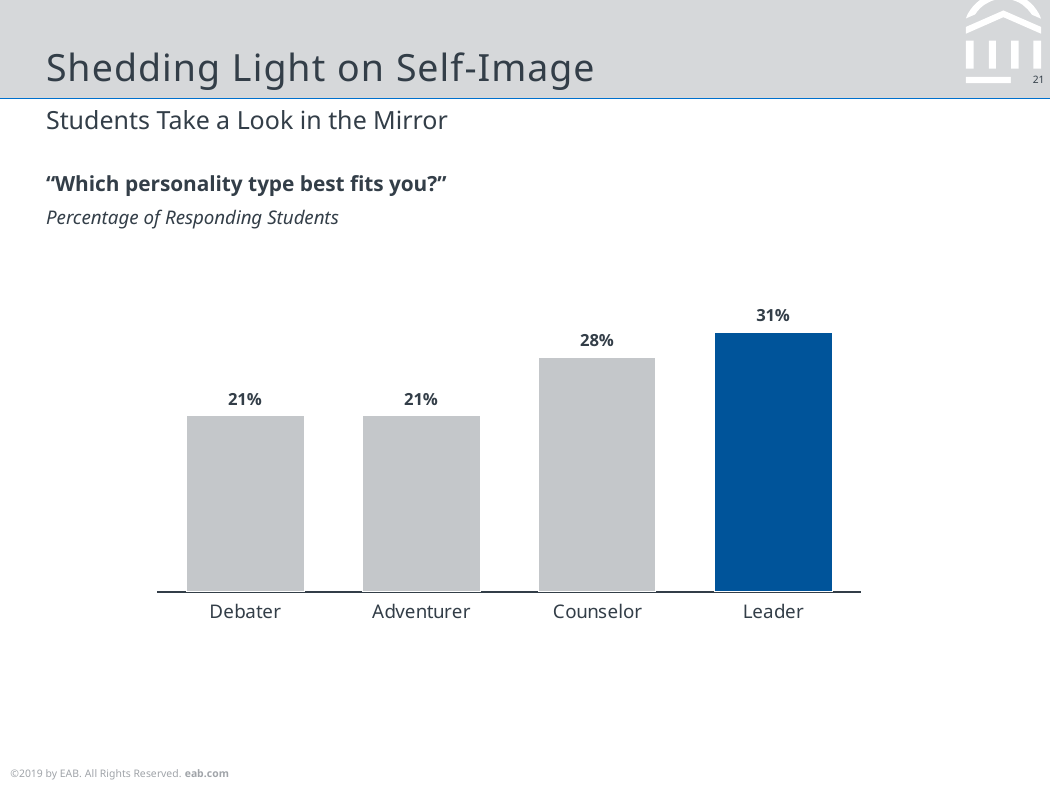
What kind of chart is used to show the personality type responses? Bar chart How many personality types are shown in the chart? 4 What percentage of responding students chose Leader as the personality type that best fits them? 31% What percentage of responding students chose Counselor? 28% What percentage of responding students chose Debater? 21% What is the difference in percentage points between Leader and Debater? 10 Which two personality types have the same percentage of responding students? Debater and Adventurer What is the difference in percentage points between Leader and Counselor? 3 Which bar in the chart is highlighted in blue? Leader Which personality type has the highest percentage of responding students? Leader Do the values rise or fall moving from Debater to Leader along the x axis? Rise Which has a larger percentage of responding students, Counselor or Adventurer? Counselor